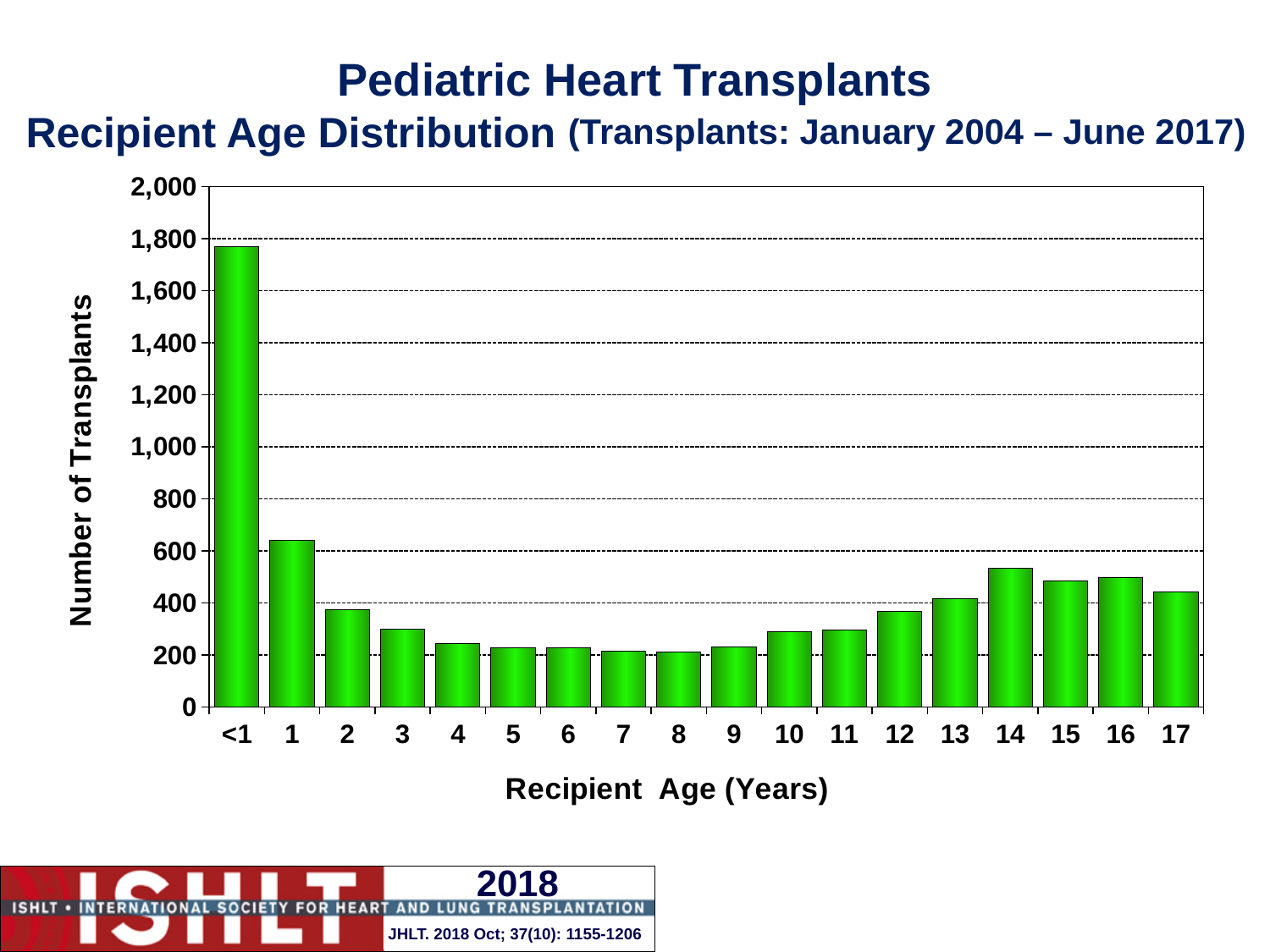
Which has more transplants, recipients aged 14 or recipients aged 13? 14 What kind of chart is shown on the slide? bar chart Which has more transplants, recipients aged 2 or recipients aged 3? 2 Is the number of transplants for recipients aged <1 greater or less than 1,600? greater What is the label of the y axis? Number of Transplants Is the number of transplants for recipients aged 14 greater or less than 400? greater How many recipient age categories are shown on the x axis? 18 Is the number of transplants for recipients aged 2 greater or less than 400? less Do the number of transplants rise or fall from recipient age 1 to recipient age 8? fall Which recipient age group has the highest number of transplants? <1